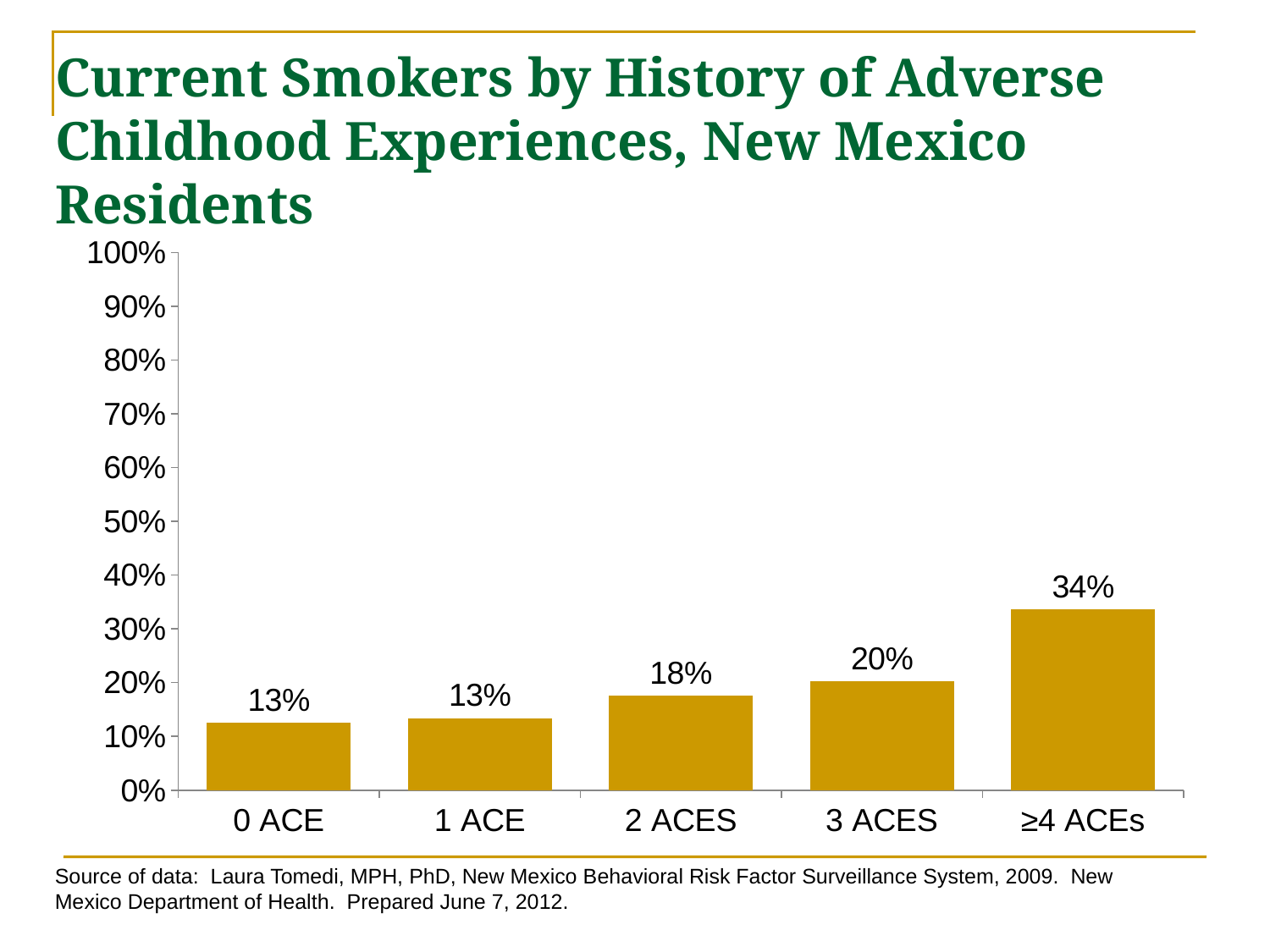
Which is larger, the value for 2 ACES or the value for 3 ACES? 3 ACES What is the value shown for 2 ACES? 18% Is the value for ≥4 ACEs greater or less than 30%? greater What kind of chart is shown on the slide? bar chart How many categories are shown on the x axis? 5 What is the value shown for ≥4 ACEs? 34% What is the value shown for 3 ACES? 20% Do the values rise or fall as the number of ACEs increases along the x axis? rise What is the difference in percentage points between 3 ACES and 2 ACES? 2 Which category has the highest percentage of current smokers? ≥4 ACEs What is the difference in percentage points between ≥4 ACEs and 0 ACE? 21 What percentage of New Mexico residents with 0 ACE are current smokers? 13%